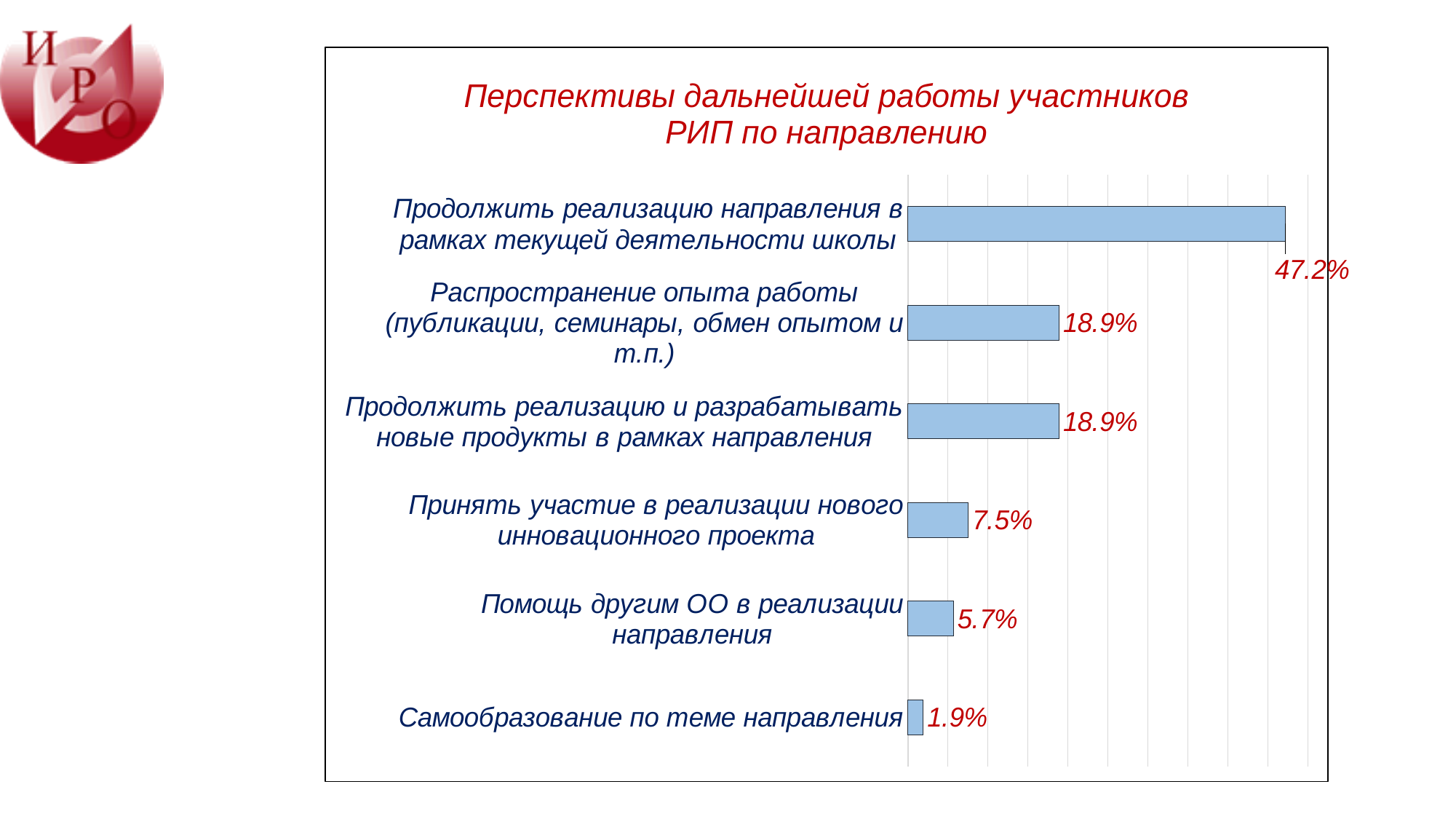
Which is larger: the value for "Принять участие в реализации нового инновационного проекта" or for "Самообразование по теме направления"? Принять участие в реализации нового инновационного проекта What is the value for "Принять участие в реализации нового инновационного проекта"? 7.5% What kind of chart is shown on the slide? Bar chart What is the value for "Продолжить реализацию направления в рамках текущей деятельности школы"? 47.2% What is the value for "Самообразование по теме направления"? 1.9% Which category has the lowest value? Самообразование по теме направления What is the value for "Помощь другим ОО в реализации направления"? 5.7% What is the difference between the values for "Принять участие в реализации нового инновационного проекта" and "Помощь другим ОО в реализации направления"? 1.8% What is the title of the chart? Перспективы дальнейшей работы участников РИП по направлению What is the difference between the values for "Продолжить реализацию направления в рамках текущей деятельности школы" and "Распространение опыта работы (публикации, семинары, обмен опытом и т.п.)"? 28.3% How many categories are shown in the chart? 6 Which category has the highest value? Продолжить реализацию направления в рамках текущей деятельности школы